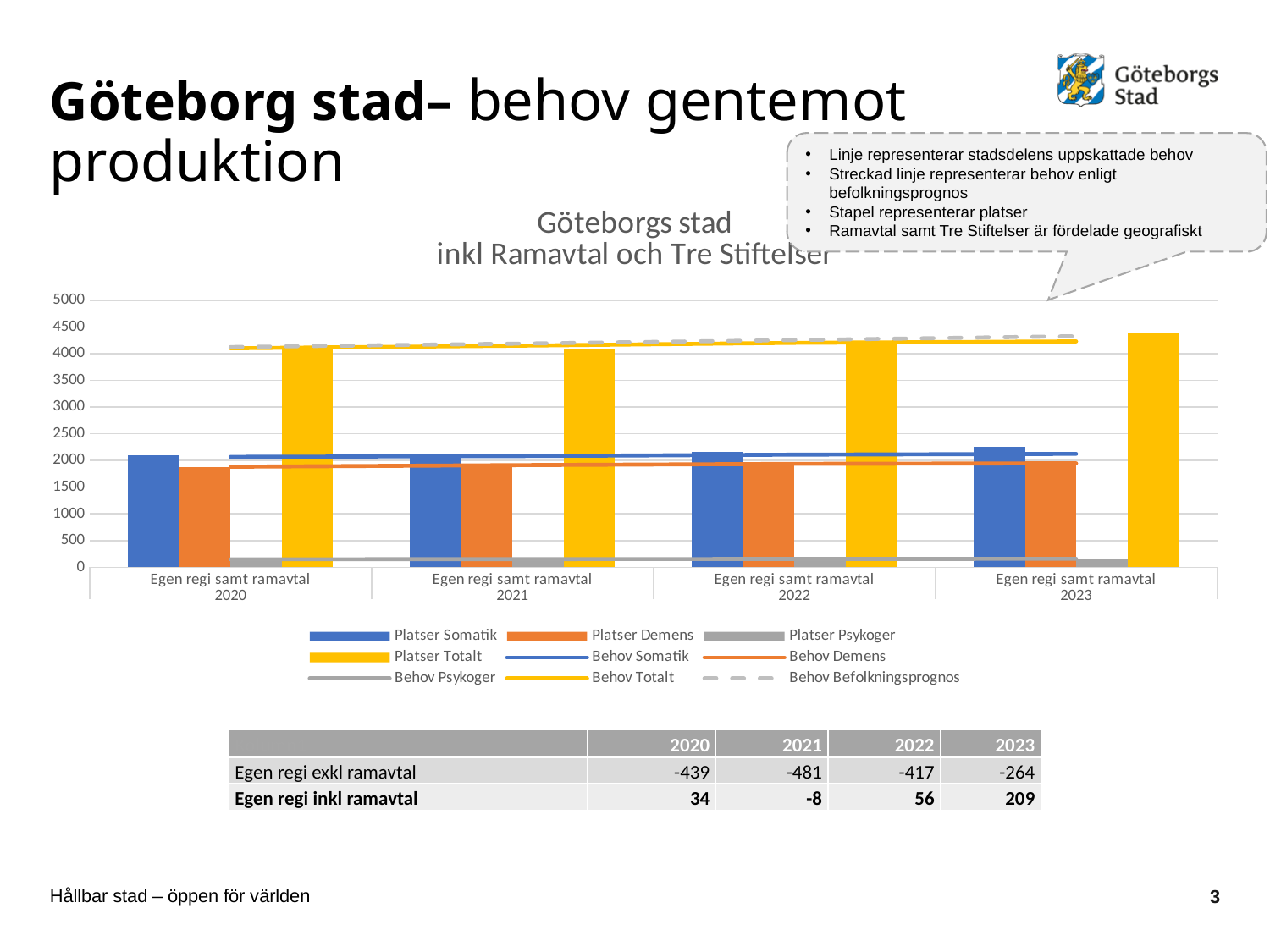
What kind of chart is shown on the slide? A combined bar and line chart Which series in the legend is drawn as a dashed line? Behov Befolkningsprognos Is the Platser Psykoger bar for 2020 greater or less than 500? less Is the Platser Totalt bar for 2023 greater or less than 4000? greater Which bar series has the lowest values in every year? Platser Psykoger How many year categories are shown on the x axis of the chart? 4 Is the Platser Totalt bar for 2022 greater or less than 4000? greater What is the title of the chart? Göteborgs stad inkl Ramavtal och Tre Stiftelser How many series does the chart legend list? 9 In which year is the Platser Totalt bar highest? 2023 In 2023, which bar is taller: Platser Somatik or Platser Demens? Platser Somatik